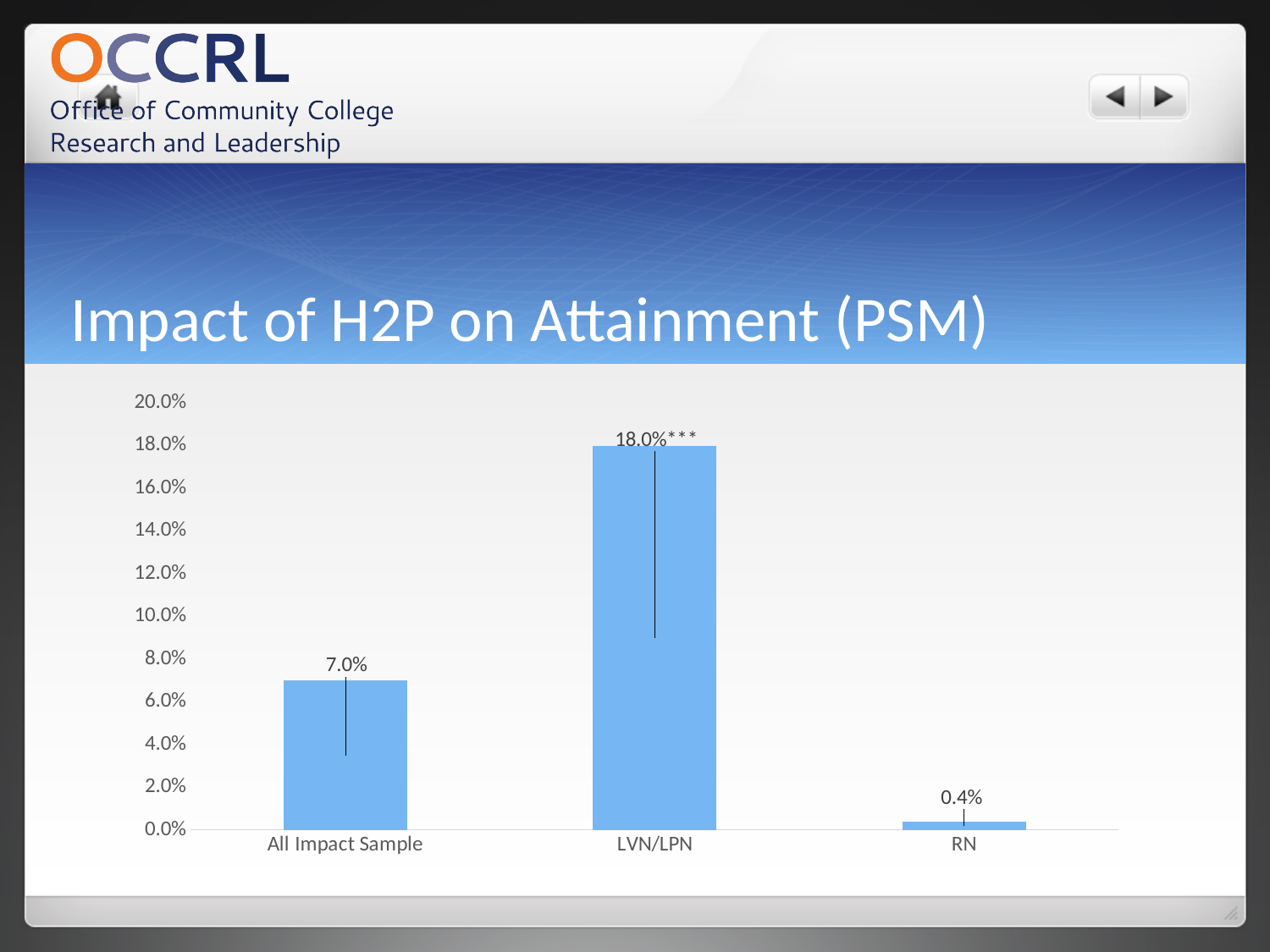
How many categories are shown on the x axis? 3 What kind of chart is shown on the slide? bar chart Is the value for LVN/LPN greater or less than 16.0%? greater Which category has the highest value? LVN/LPN Which is larger, the value for All Impact Sample or the value for RN? All Impact Sample What is the value for LVN/LPN? 18.0% What is the title of the slide containing the chart? Impact of H2P on Attainment (PSM) What is the value for All Impact Sample? 7.0% What is the difference between the values for All Impact Sample and RN? 6.6% Which category has the lowest value? RN What is the value for RN? 0.4% What is the difference between the values for LVN/LPN and All Impact Sample? 11.0%